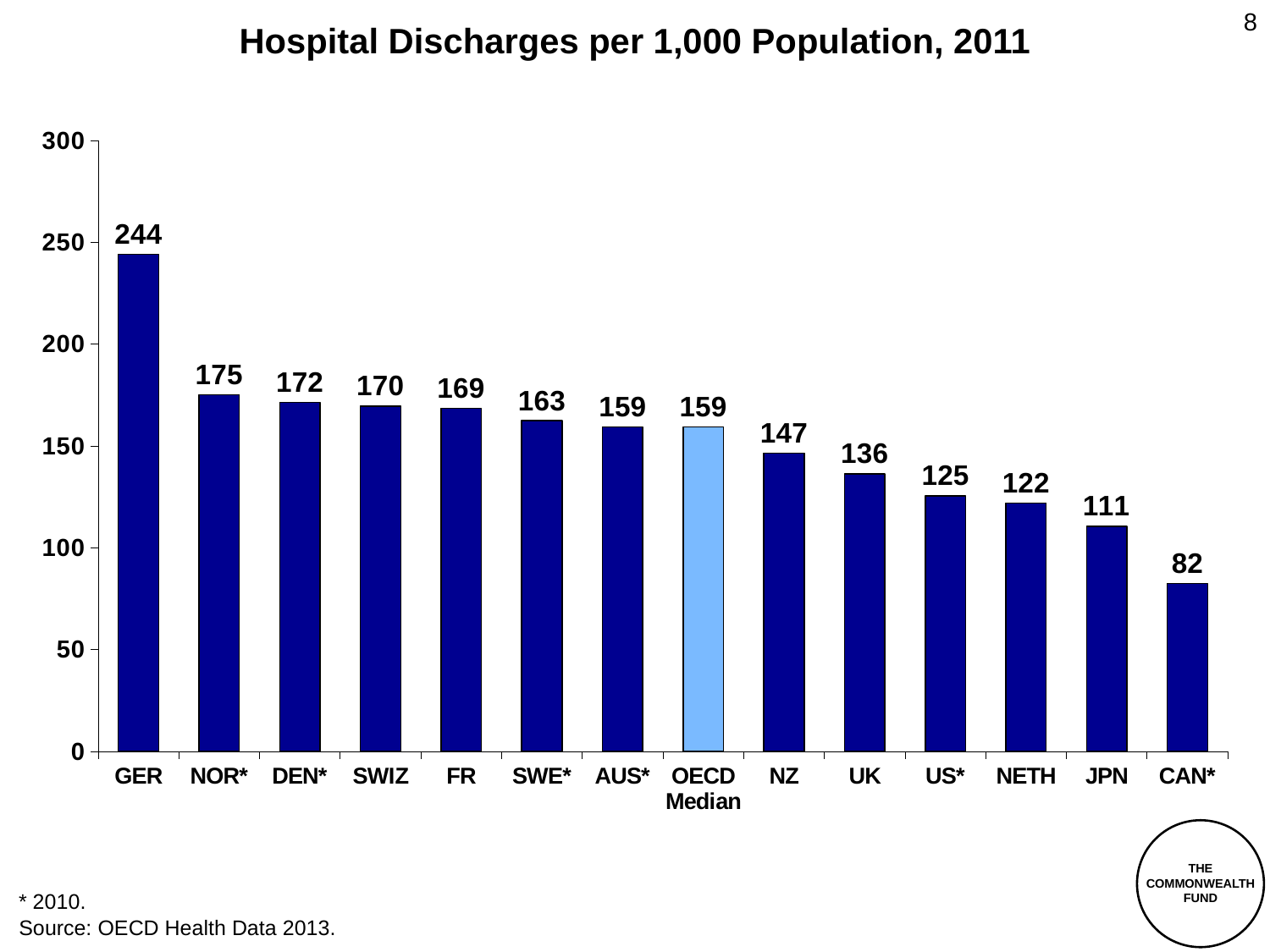
Which category has the highest value? GER What is the value for the OECD Median? 159 Which is larger, the value for NZ or the value for NETH? NZ Is the value for JPN greater or less than 100? greater How many bars are shown in the chart? 14 What is the title of the chart? Hospital Discharges per 1,000 Population, 2011 What is the difference between the values for UK and CAN*? 54 What is the value for GER? 244 Which category has the lowest value? CAN* What is the value for US*? 125 What kind of chart is shown on the slide? bar chart What is the difference between the values for GER and NOR*? 69